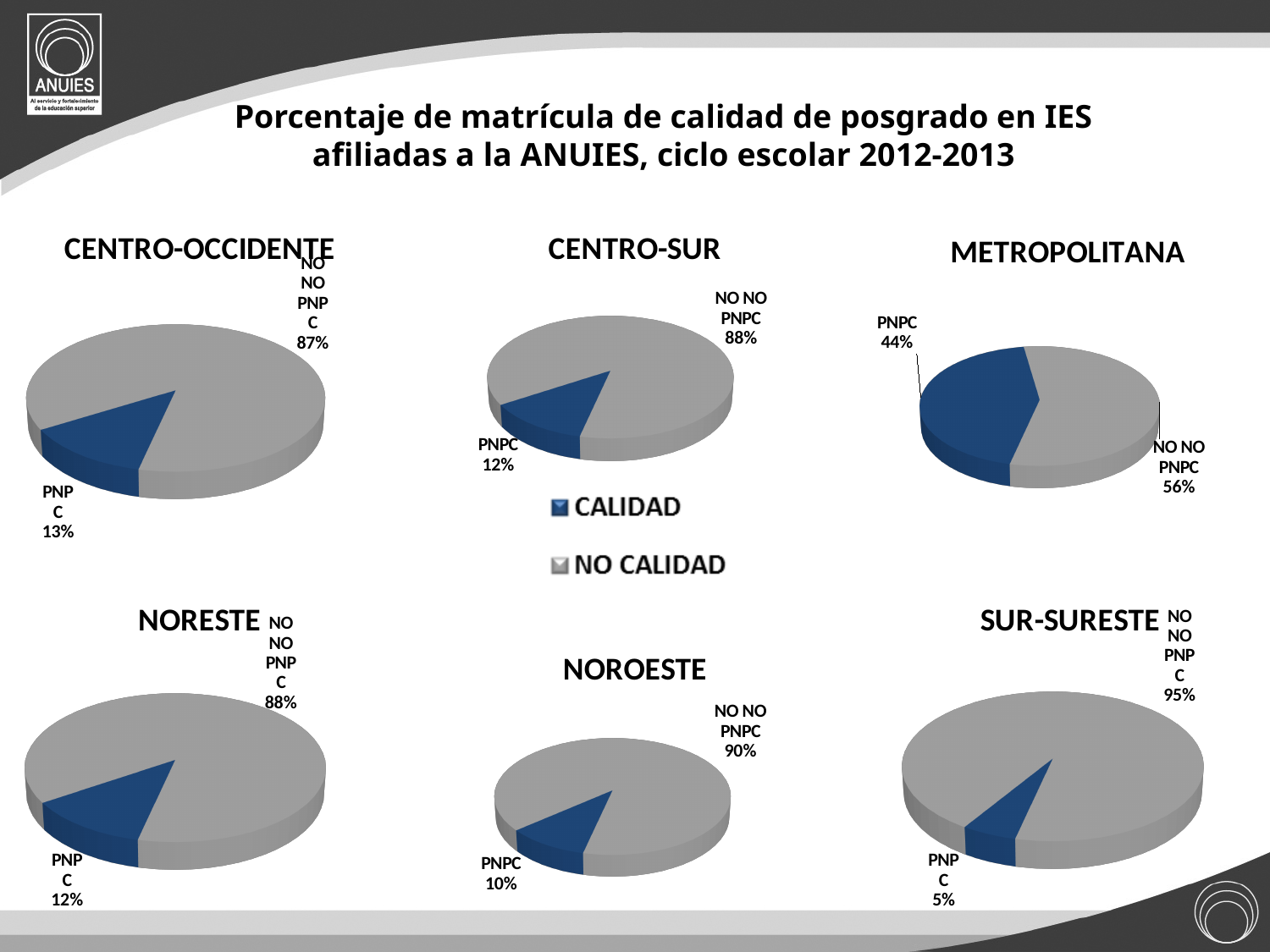
In the NOROESTE pie chart, what share is labelled PNPC? 10% What kind of chart is used for each region on this slide? Pie chart In the SUR-SURESTE pie chart, what is the difference between the NO PNPC share and the PNPC share? 90% In the SUR-SURESTE pie chart, what share is labelled NO PNPC? 95% In the NORESTE pie chart, what share is labelled NO PNPC? 88% In the METROPOLITANA pie chart, which slice is larger, PNPC or NO PNPC? NO PNPC How many entries does the legend in the middle of the slide list? 2